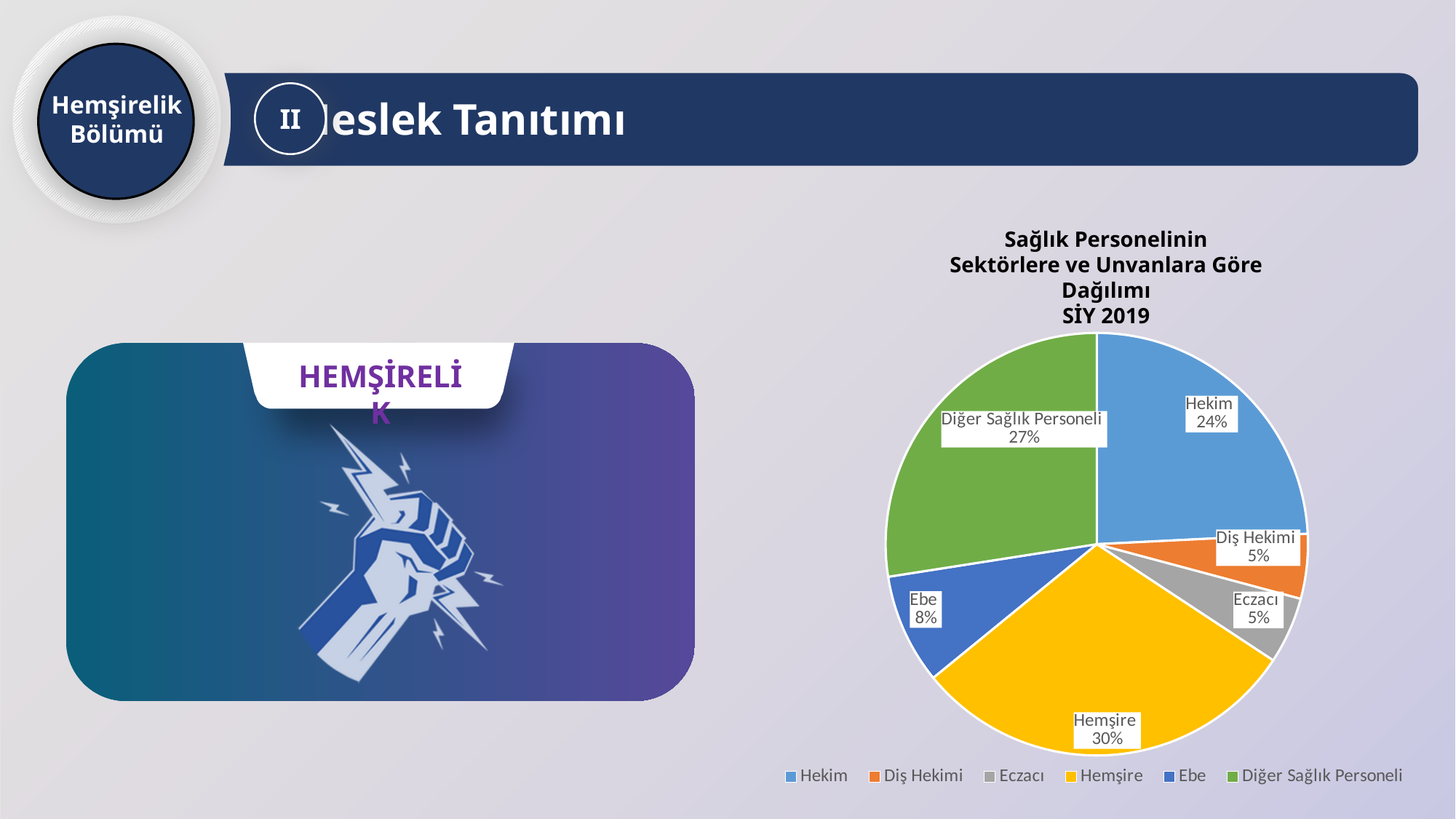
What share of the pie does Hemşire hold? 30% What kind of chart is shown on the slide? Pie chart What is the difference between the Hemşire and Hekim shares? 6% Which is larger, the share for Hekim or the share for Diğer Sağlık Personeli? Diğer Sağlık Personeli How many categories are shown in the pie chart? 6 What is the value shown for Ebe? 8% What is the combined share of Diş Hekimi and Eczacı? 10% What is the value shown for Hekim? 24% What is the difference between the Diğer Sağlık Personeli and Ebe shares? 19% Which category has the largest slice of the pie? Hemşire Which colour represents Hemşire in the pie chart? Yellow What share of the pie does Diğer Sağlık Personeli hold? 27%